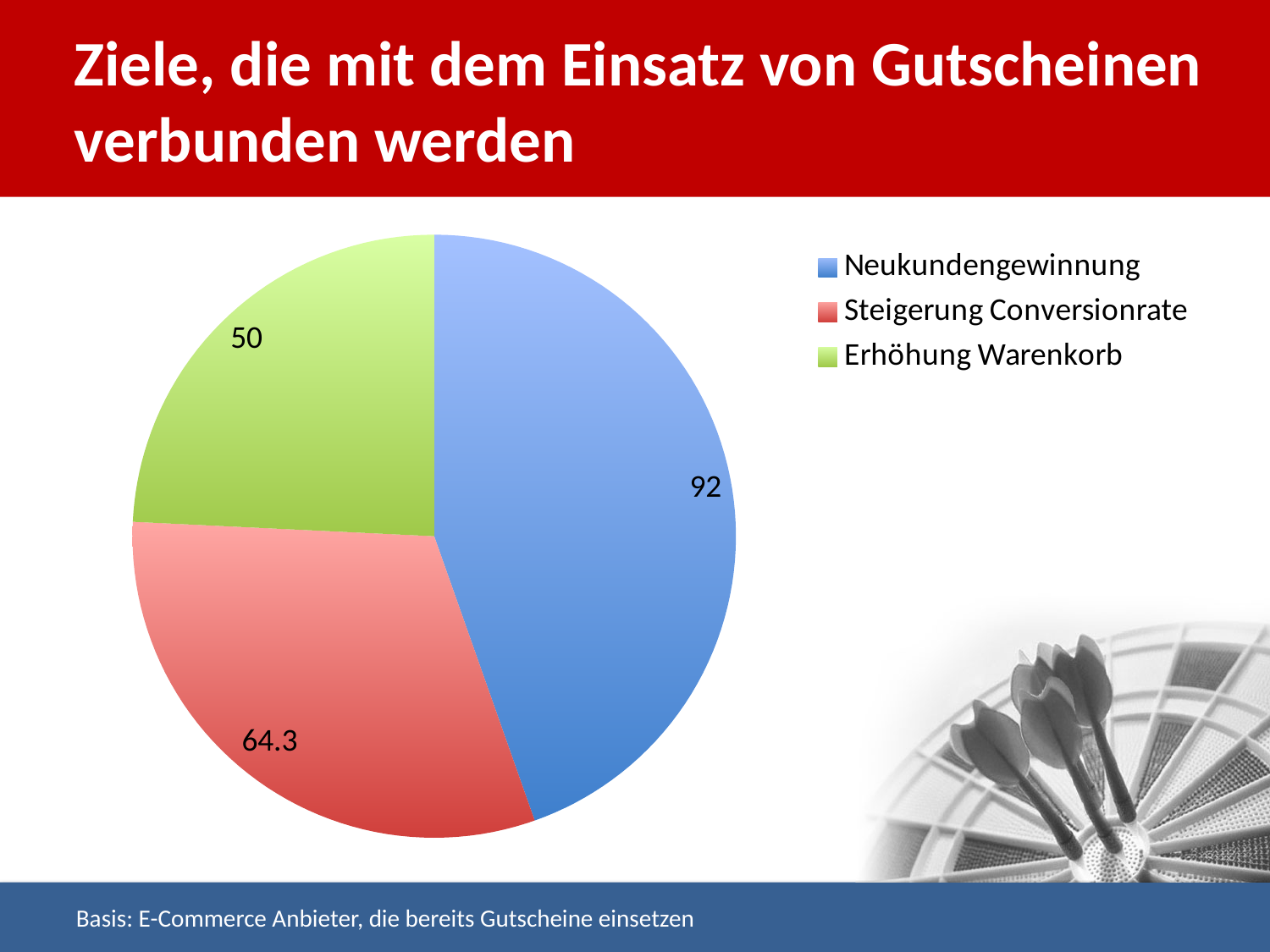
What is the value for Erhöhung Warenkorb? 50 What is the value for Neukundengewinnung? 92 Which category has the largest slice of the pie? Neukundengewinnung Which colour represents Erhöhung Warenkorb in the pie chart? green What is the value for Steigerung Conversionrate? 64.3 How many slices does the pie chart have? 3 What is the difference between the values for Neukundengewinnung and Erhöhung Warenkorb? 42 Which category has the smallest slice of the pie? Erhöhung Warenkorb What is the difference between the values for Steigerung Conversionrate and Erhöhung Warenkorb? 14.3 What is the total of all three values in the pie chart? 206.3 Which is larger, the value for Steigerung Conversionrate or the value for Erhöhung Warenkorb? Steigerung Conversionrate What kind of chart is shown on the slide? pie chart